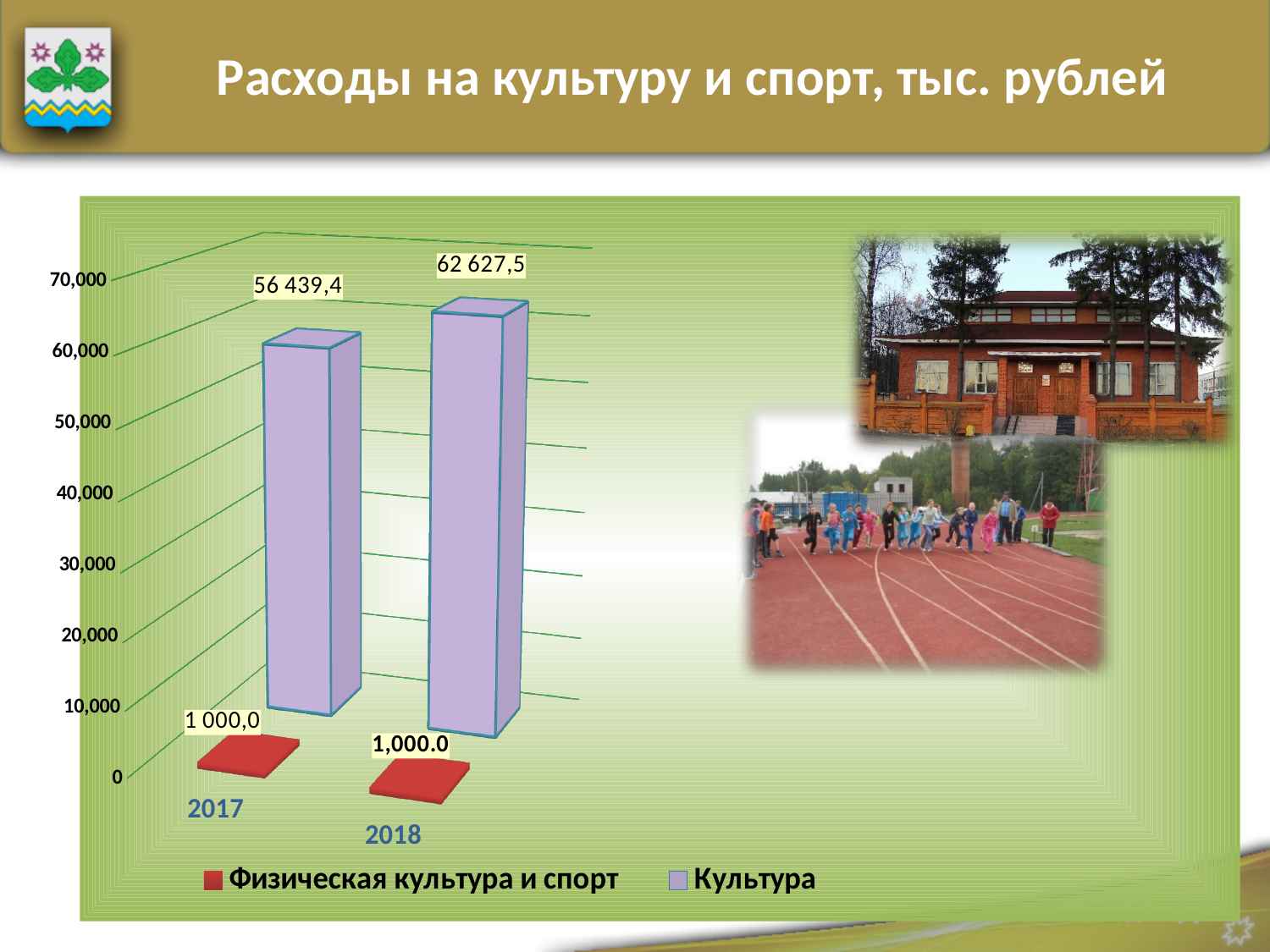
Is the value for Культура in 2017 greater or less than 50,000? greater By how much did the value for Культура increase from 2017 to 2018? 6 188,1 What kind of chart is shown on the slide? bar chart In which year is the value for Культура higher? 2018 Does the value for Культура rise or fall from 2017 to 2018? rise How many series does the legend list? 2 Which is larger in 2018: Культура or Физическая культура и спорт? Культура What is the value for Культура in 2017? 56 439,4 What is the value for Физическая культура и спорт in 2017? 1 000,0 What is the value for Физическая культура и спорт in 2018? 1,000.0 How many years are shown on the x axis? 2 What is the value for Культура in 2018? 62 627,5